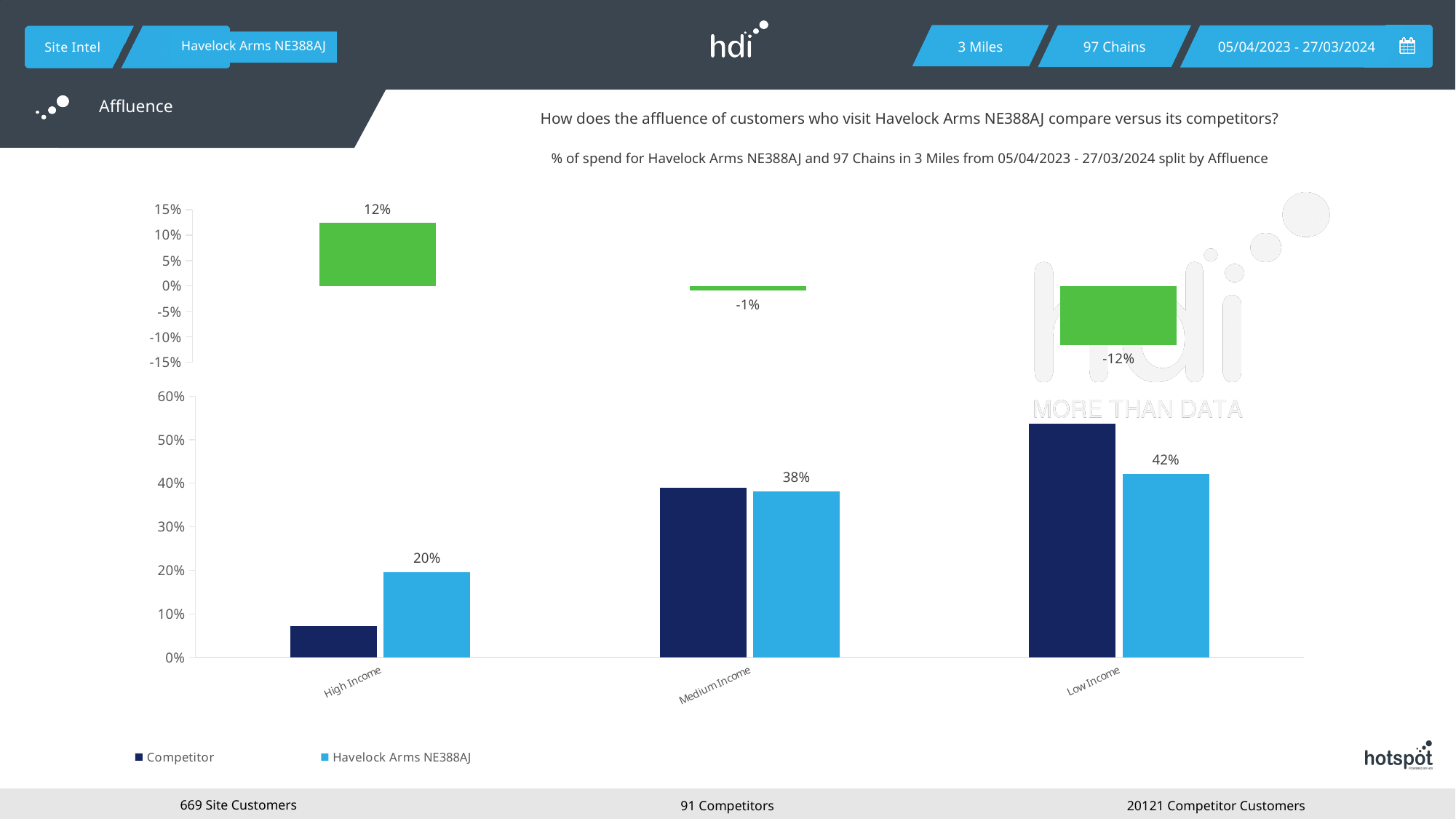
In the bottom chart, which category has the highest value for Havelock Arms NE388AJ? Low Income In the bottom chart, is the Competitor value for Low Income greater or less than 50%? greater In the bottom chart, what is the value for Havelock Arms NE388AJ in the High Income category? 20% In the bottom chart, which category has the lowest value for Competitor? High Income In the bottom chart, what is the value for Havelock Arms NE388AJ in the Medium Income category? 38% In the top chart, what is the value shown for Medium Income? -1% In the top chart, what is the value shown for Low Income? -12% In the bottom chart, what is the difference between the Havelock Arms NE388AJ values for Low Income and High Income? 22% How many series does the legend of the bottom chart list? 2 In the top chart, what is the value shown for High Income? 12% In the bottom chart, which is larger in the High Income category: Competitor or Havelock Arms NE388AJ? Havelock Arms NE388AJ In the bottom chart, what is the value for Havelock Arms NE388AJ in the Low Income category? 42%